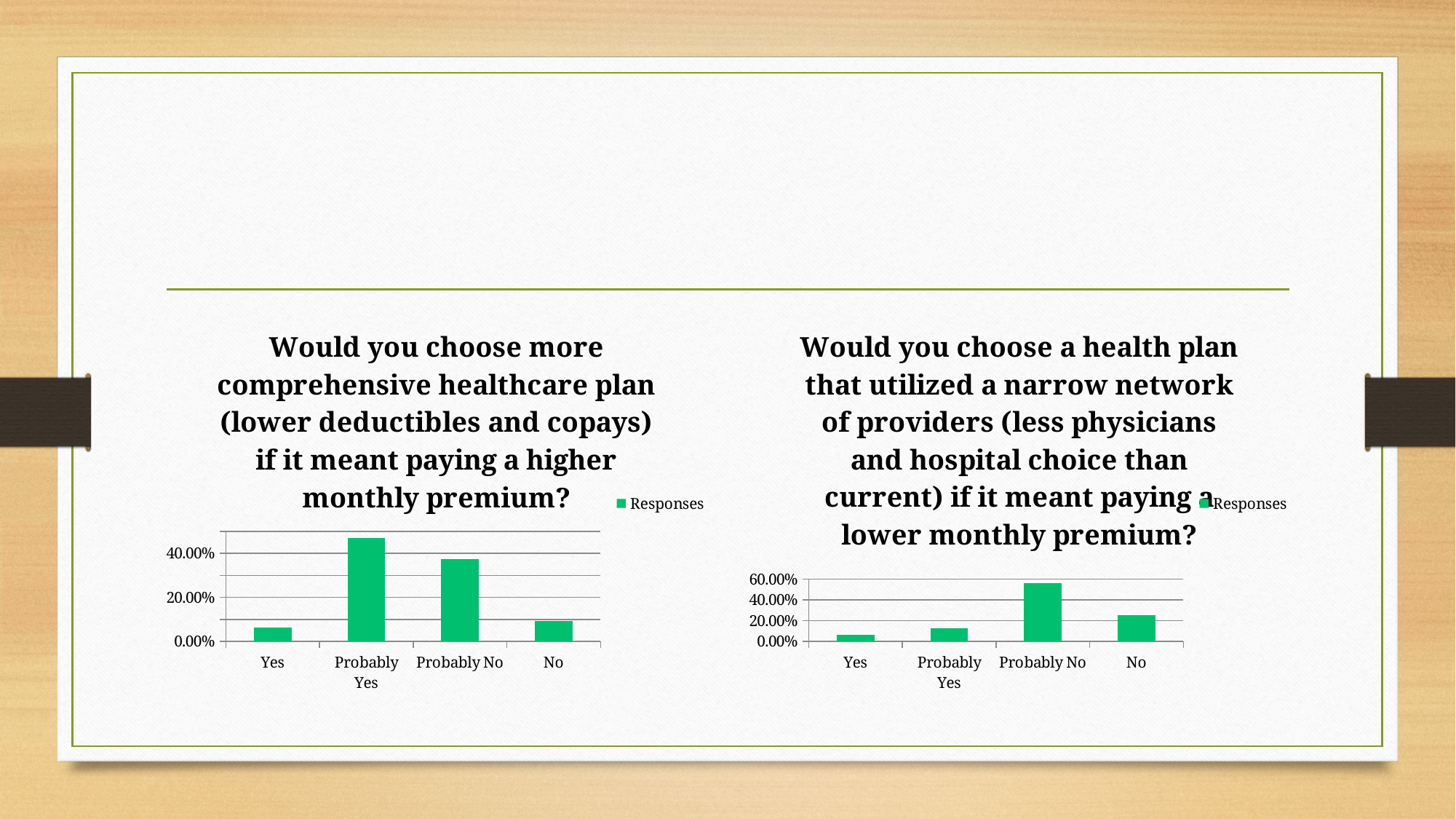
In the right chart (narrow network health plan), is the value for Probably No greater or less than 40.00%? greater What kind of chart is the left chart, titled "Would you choose more comprehensive healthcare plan..."? bar chart How many response categories are shown on the x axis of the right chart (narrow network health plan)? 4 In the left chart (more comprehensive healthcare plan), is the value for No greater or less than 20.00%? less In the left chart (more comprehensive healthcare plan), which response category has the highest value? Probably Yes How many series does the legend of the right chart (narrow network health plan) list? 1 In the right chart (narrow network health plan), which response category has the highest value? Probably No In the left chart (more comprehensive healthcare plan), is the value for Probably Yes greater or less than 40.00%? greater In the left chart (more comprehensive healthcare plan), which response category has the lowest value? Yes In the right chart (narrow network health plan), which response category has the lowest value? Yes In the right chart (narrow network health plan), which is larger, the value for No or the value for Probably Yes? No In the left chart (more comprehensive healthcare plan), which is larger, the value for Probably Yes or the value for Probably No? Probably Yes